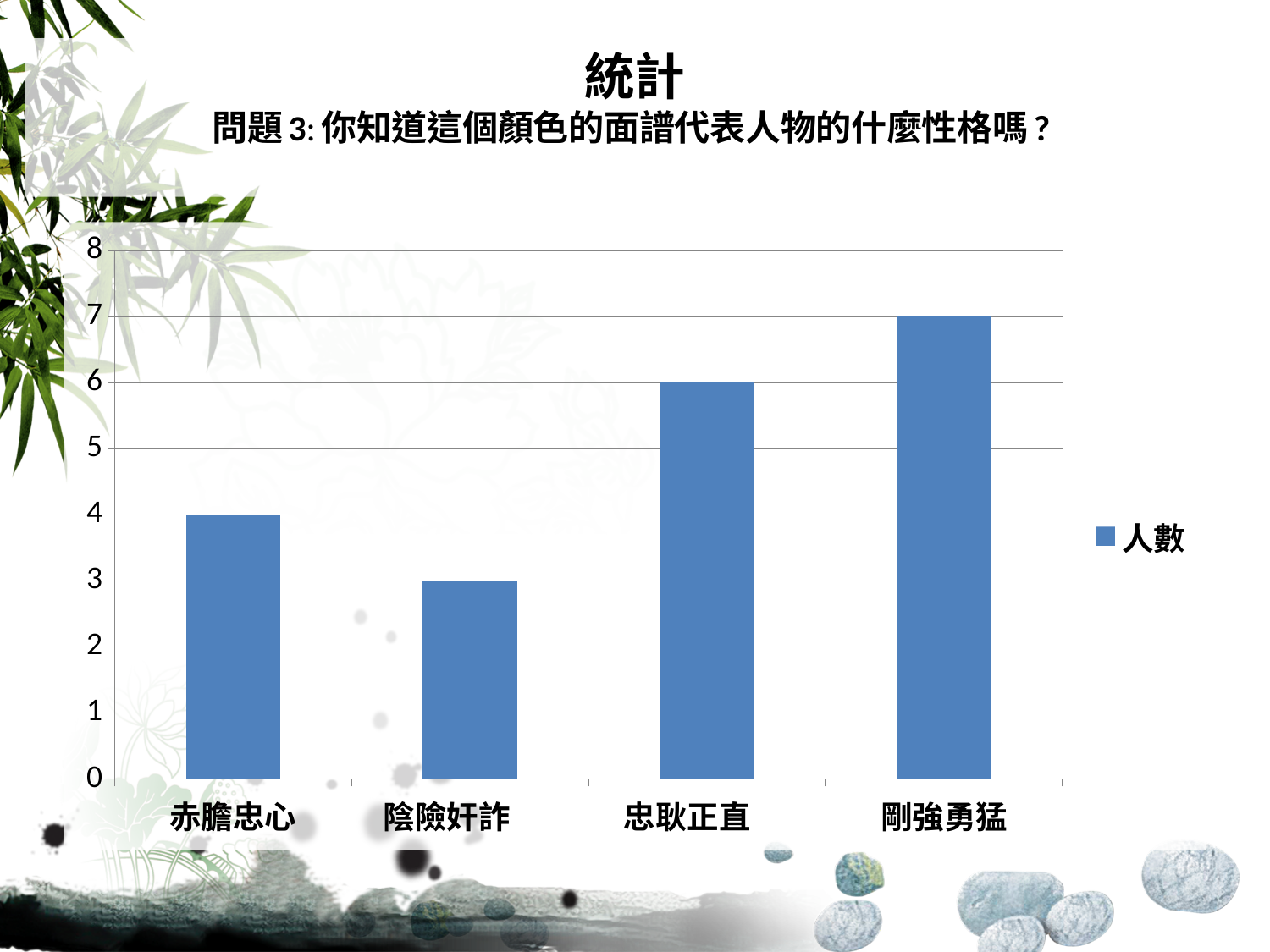
What series name does the legend show? 人數 What is the difference between the values for 剛強勇猛 and 陰險奸詐? 4 How many categories are shown on the x axis? 4 Is the value for 忠耿正直 greater or less than 5? greater Which category has the lowest value? 陰險奸詐 What is the value for 剛強勇猛? 7 What is the value for 忠耿正直? 6 What is the value for 陰險奸詐? 3 Which category has the highest value? 剛強勇猛 What kind of chart is shown on the slide? bar chart Which is larger, the value for 赤膽忠心 or the value for 忠耿正直? 忠耿正直 What is the value for 赤膽忠心? 4